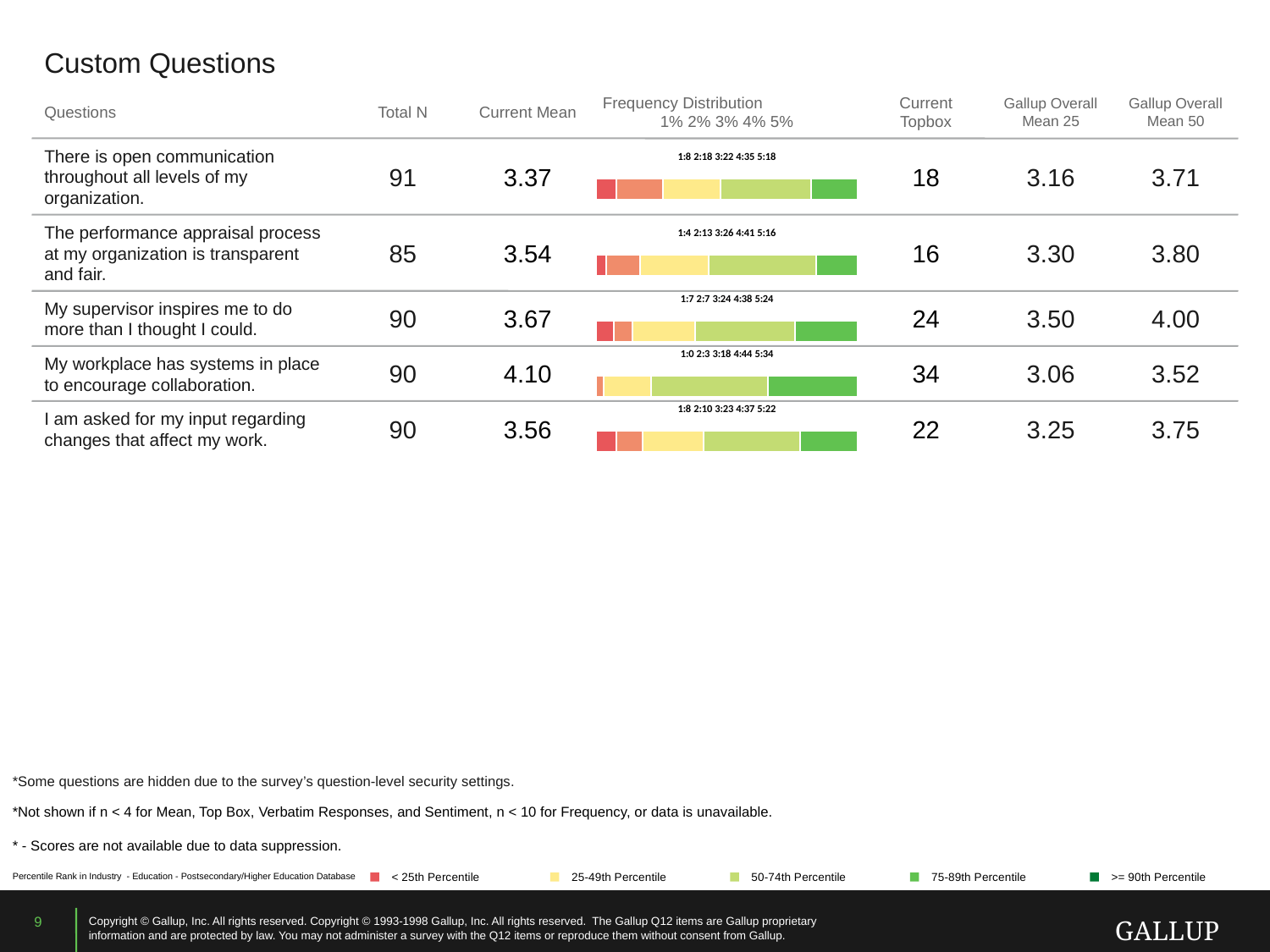
In the frequency distribution bar for "I am asked for my input regarding changes that affect my work.", what is the difference between the share of 4 responses and the share of 5 responses? 15% Comparing the frequency distribution bars, which question has the higher share of 5 responses: "My supervisor inspires me to do more than I thought I could." or "There is open communication throughout all levels of my organization."? My supervisor inspires me to do more than I thought I could. In the frequency distribution bar for "The performance appraisal process at my organization is transparent and fair.", what percentage of responses are a 1? 4% In the frequency distribution bar for "The performance appraisal process at my organization is transparent and fair.", which is larger: the share of 3 responses or the share of 5 responses? 3 responses How many response categories (1 through 5) does each frequency distribution bar break down? 5 What kind of chart is used to show the frequency distribution for each question? Stacked bar chart In the frequency distribution bar for "My workplace has systems in place to encourage collaboration.", what percentage of responses are a 5? 34% How many frequency distribution bars are shown on the slide? 5 In the frequency distribution bar for "There is open communication throughout all levels of my organization.", what percentage of responses are a 4? 35% In the frequency distribution bars, what colour is used for the 5 responses segment? Green In the frequency distribution bar for "My supervisor inspires me to do more than I thought I could.", which response value has the largest share? 4 In the frequency distribution bar for "My workplace has systems in place to encourage collaboration.", which response value has the smallest share? 1